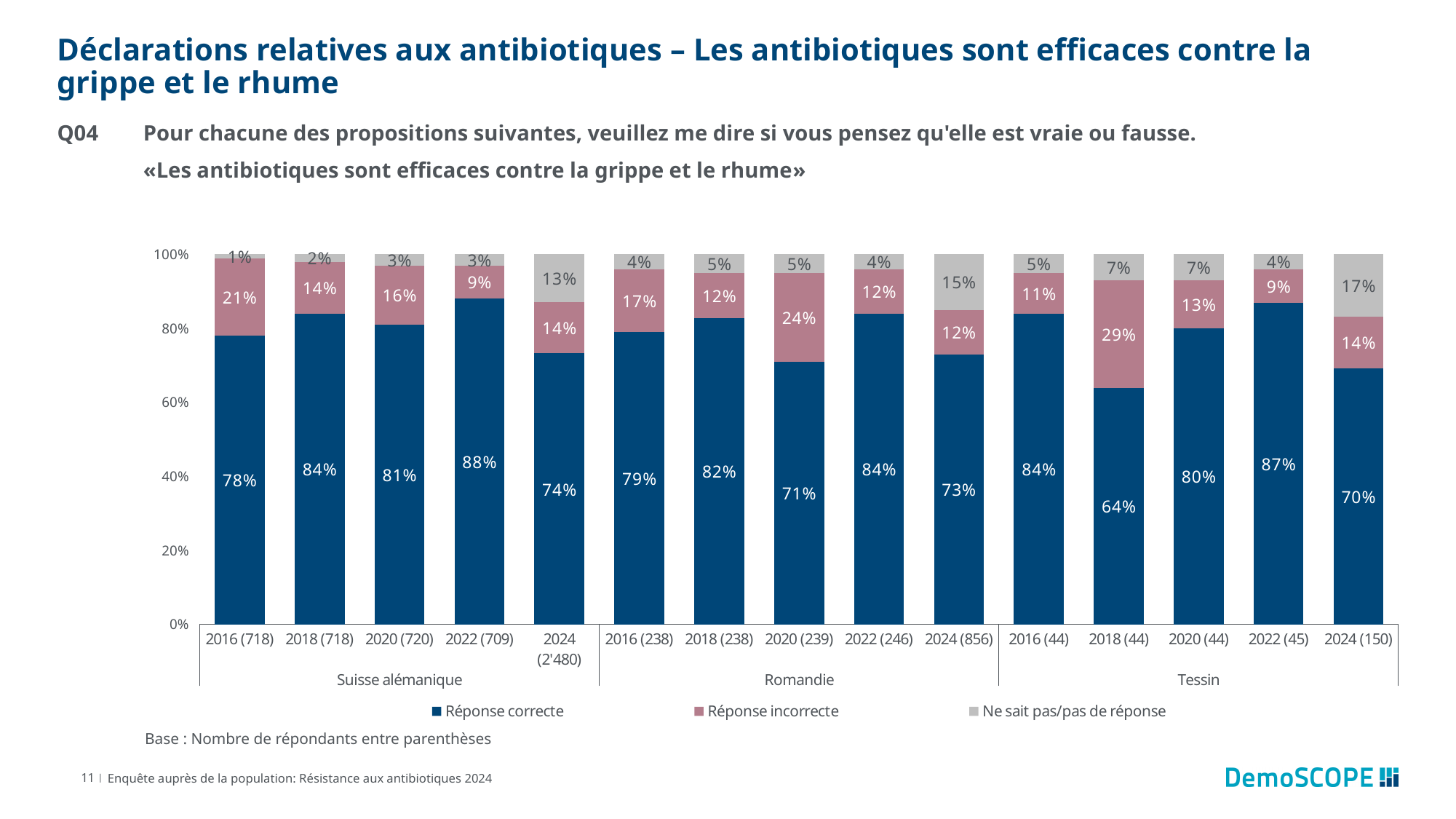
Which series is shown in dark blue in the chart? Réponse correcte What is the 'Réponse correcte' value for Suisse alémanique in 2022 (709)? 88% What is the 'Réponse incorrecte' value for Tessin in 2018 (44)? 29% Which bar has the lowest 'Réponse correcte' value across all regions and years? Tessin 2018 (44) How many series does the legend list? 3 Is the 'Réponse correcte' value for Tessin in 2024 (150) greater or less than 80%? less What is the 'Ne sait pas/pas de réponse' value for Romandie in 2024 (856)? 15% Within Suisse alémanique, which year has the highest 'Réponse correcte' value? 2022 (709) What is the difference between the 'Réponse correcte' values for Romandie in 2022 (246) and 2024 (856)? 11 percentage points Which is larger: the 'Réponse incorrecte' value for Suisse alémanique in 2016 (718) or for Romandie in 2020 (239)? Romandie 2020 (239) How many bars are plotted in the chart? 15 What kind of chart is shown on the slide? Stacked bar chart